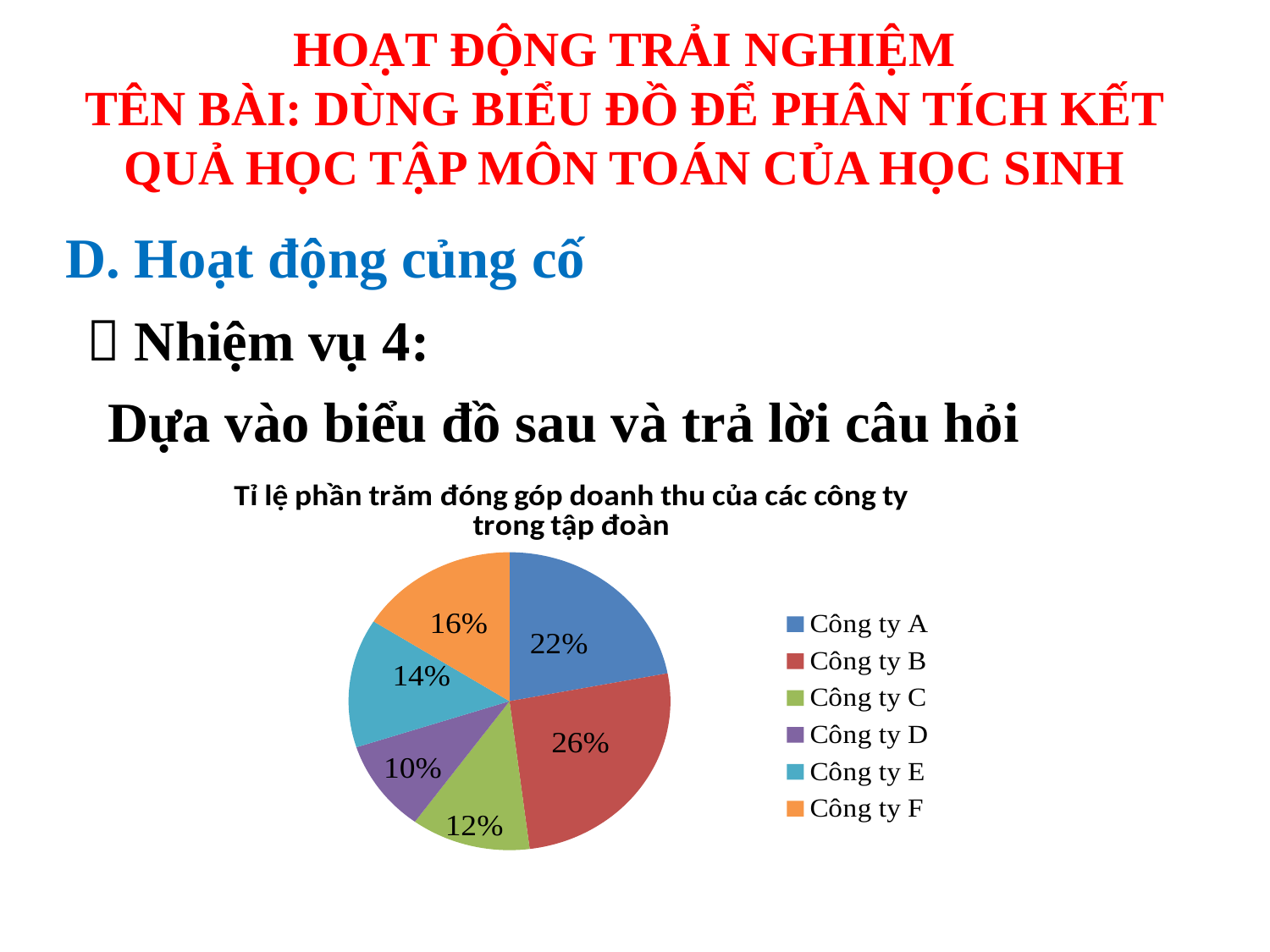
Which has a larger share, Công ty E or Công ty F? Công ty F What is the difference in percentage points between Công ty B and Công ty C? 14 Which company has the largest share of the pie? Công ty B What is the percentage share for Công ty B? 26% What colour is the slice for Công ty C? Green What is the percentage share for Công ty D? 10% Which company has the smallest share of the pie? Công ty D What kind of chart is shown on the slide? Pie chart What is the percentage share for Công ty A? 22% How many companies are shown in the pie chart? 6 What is the percentage share for Công ty F? 16% What is the title of the pie chart? Tỉ lệ phần trăm đóng góp doanh thu của các công ty trong tập đoàn